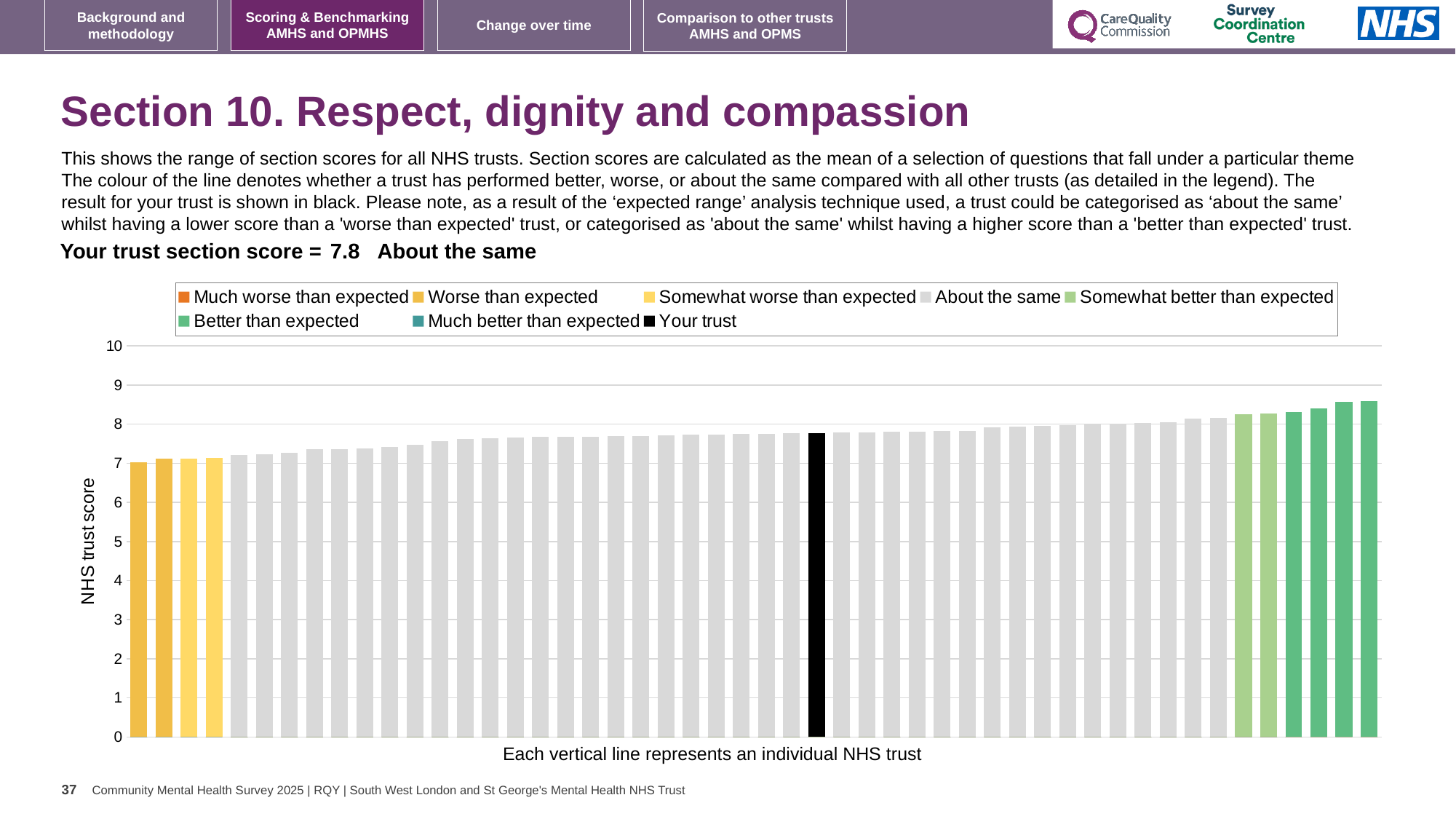
Do the bar values rise or fall from left to right along the x axis? rise What is the label on the vertical axis of the chart? NHS trust score What does the text below the horizontal axis say each vertical line represents? An individual NHS trust What kind of chart is shown on the slide? Bar chart Is the value of the tallest bar greater or less than 9? less Which category is your trust placed in for this section? About the same How many entries does the chart legend list? 8 Is the value of the black 'Your trust' bar greater or less than 7? greater What is the section score for your trust shown on the slide? 7.8 Is the value of the tallest bar greater or less than 8? greater Is the black 'Your trust' bar higher or lower than the rightmost bar? lower